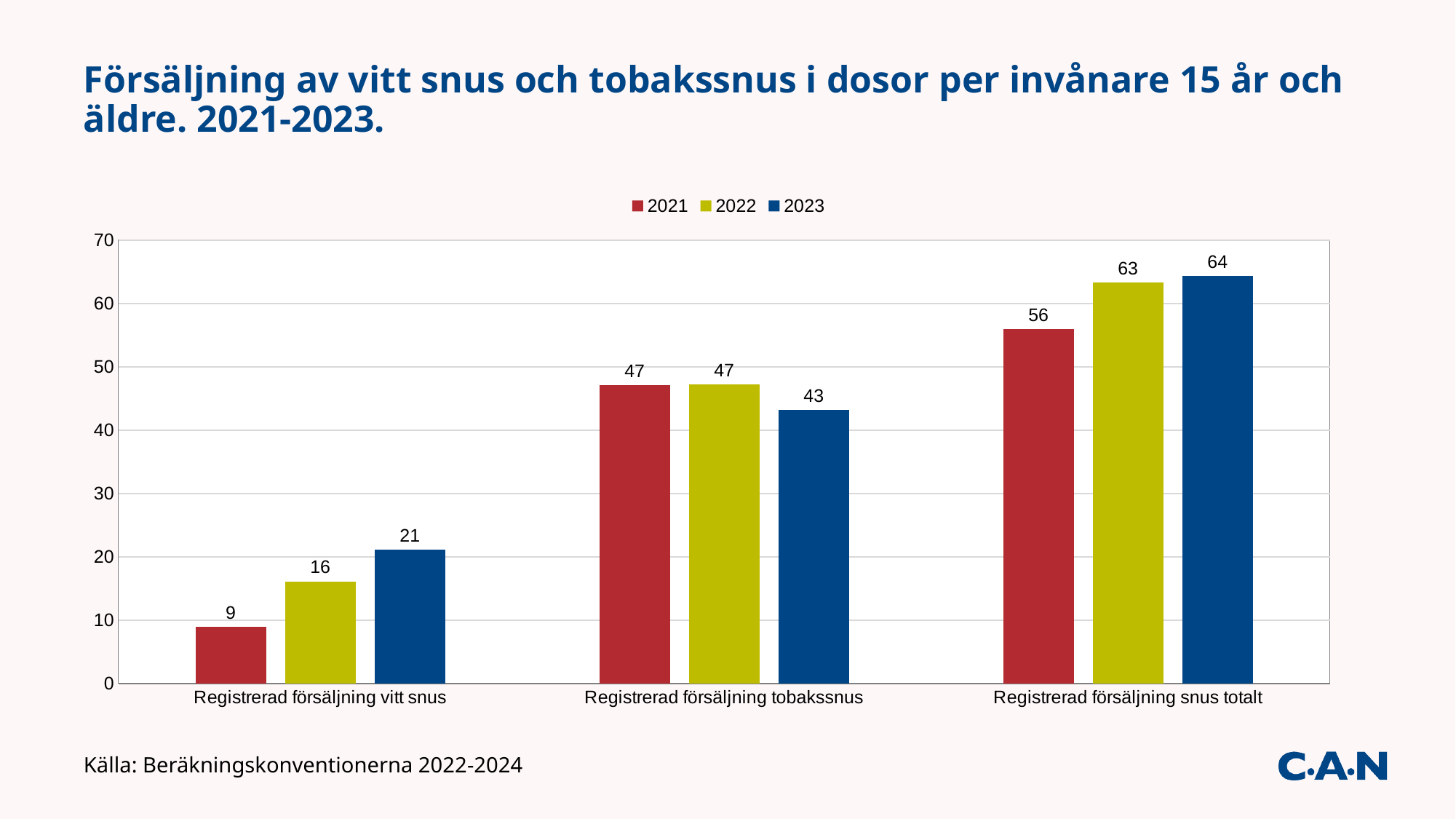
Which is larger: the 2022 value for 'Registrerad försäljning tobakssnus' or the 2022 value for 'Registrerad försäljning snus totalt'? Registrerad försäljning snus totalt Which year has the highest value in the 'Registrerad försäljning snus totalt' category? 2023 Do the values for 'Registrerad försäljning vitt snus' rise or fall from 2021 to 2023? Rise What is the value for 2022 in the 'Registrerad försäljning tobakssnus' category? 47 Which year has the lowest value in the 'Registrerad försäljning tobakssnus' category? 2023 How many categories are shown on the x axis? 3 What is the value for 2023 in the 'Registrerad försäljning vitt snus' category? 21 Is the 2021 value for 'Registrerad försäljning snus totalt' greater or less than 50? greater What is the value for 2021 in the 'Registrerad försäljning snus totalt' category? 56 What is the difference between the 2023 and 2021 values for 'Registrerad försäljning vitt snus'? 12 What kind of chart is shown on the slide? Bar chart How many series does the legend list? 3